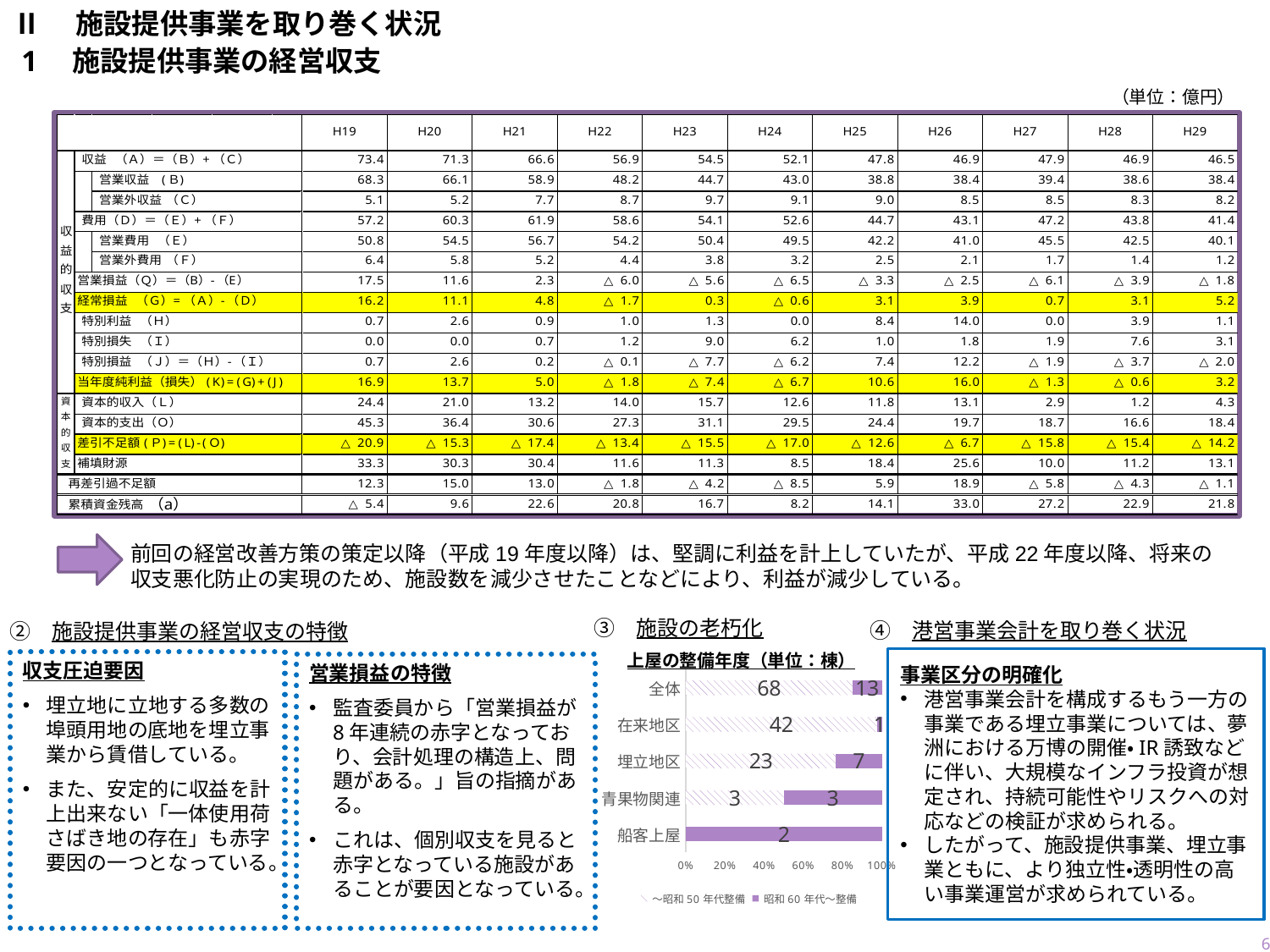
In the chart 上屋の整備年度（単位：棟）, what is the value for 在来地区 in the ～昭和50年代整備 series? 42 In the chart 上屋の整備年度（単位：棟）, what is the value for 船客上屋 in the 昭和60年代～整備 series? 2 In the chart 上屋の整備年度（単位：棟）, what is the value for 全体 in the 昭和60年代～整備 series? 13 In the chart 上屋の整備年度（単位：棟）, which category has the highest value in the ～昭和50年代整備 series? 全体 In the chart 上屋の整備年度（単位：棟）, what is the difference between the ～昭和50年代整備 values for 在来地区 and 埋立地区? 19 In the chart 上屋の整備年度（単位：棟）, what is the value for 青果物関連 in the ～昭和50年代整備 series? 3 In the chart 上屋の整備年度（単位：棟）, which category has the lowest value in the 昭和60年代～整備 series? 在来地区 In the chart 上屋の整備年度（単位：棟）, what is the value for 埋立地区 in the 昭和60年代～整備 series? 7 In the chart 上屋の整備年度（単位：棟）, what is the total of the stacked bar for 埋立地区? 30 In the chart 上屋の整備年度（単位：棟）, what is the value for 全体 in the ～昭和50年代整備 series? 68 In the chart 上屋の整備年度（単位：棟）, how many categories are shown on the vertical axis? 5 In the chart 上屋の整備年度（単位：棟）, how many series does the legend list? 2